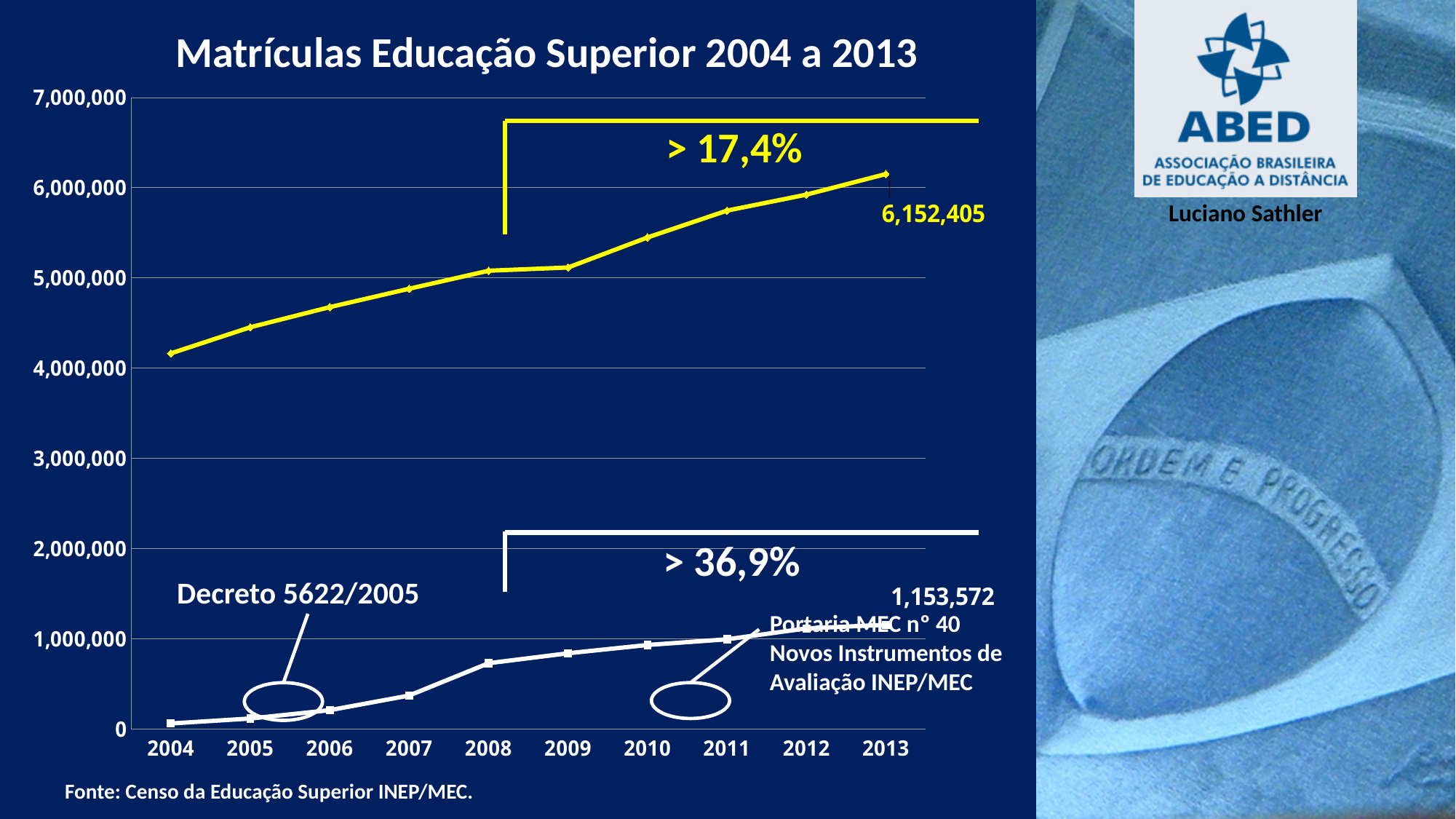
What is the value labelled for the upper (yellow) line in 2013? 6,152,405 Is the value of the lower (white) line in 2008 greater or less than 1,000,000? less Do the values of the upper (yellow) line rise or fall from 2004 to 2013? rise How many years are plotted along the x axis? 10 What percentage annotation is shown above the upper (yellow) line? > 17,4% What is the title of the chart? Matrículas Educação Superior 2004 a 2013 What is the value labelled for the lower (white) line in 2013? 1,153,572 In which year does the lower (white) line reach its highest value? 2013 In which year does the upper (yellow) line have its lowest value? 2004 Is the value of the upper (yellow) line in 2004 greater or less than 5,000,000? less What is the difference between the 2013 values of the upper (yellow) line and the lower (white) line? 4,998,833 What kind of chart is shown on the slide? line chart